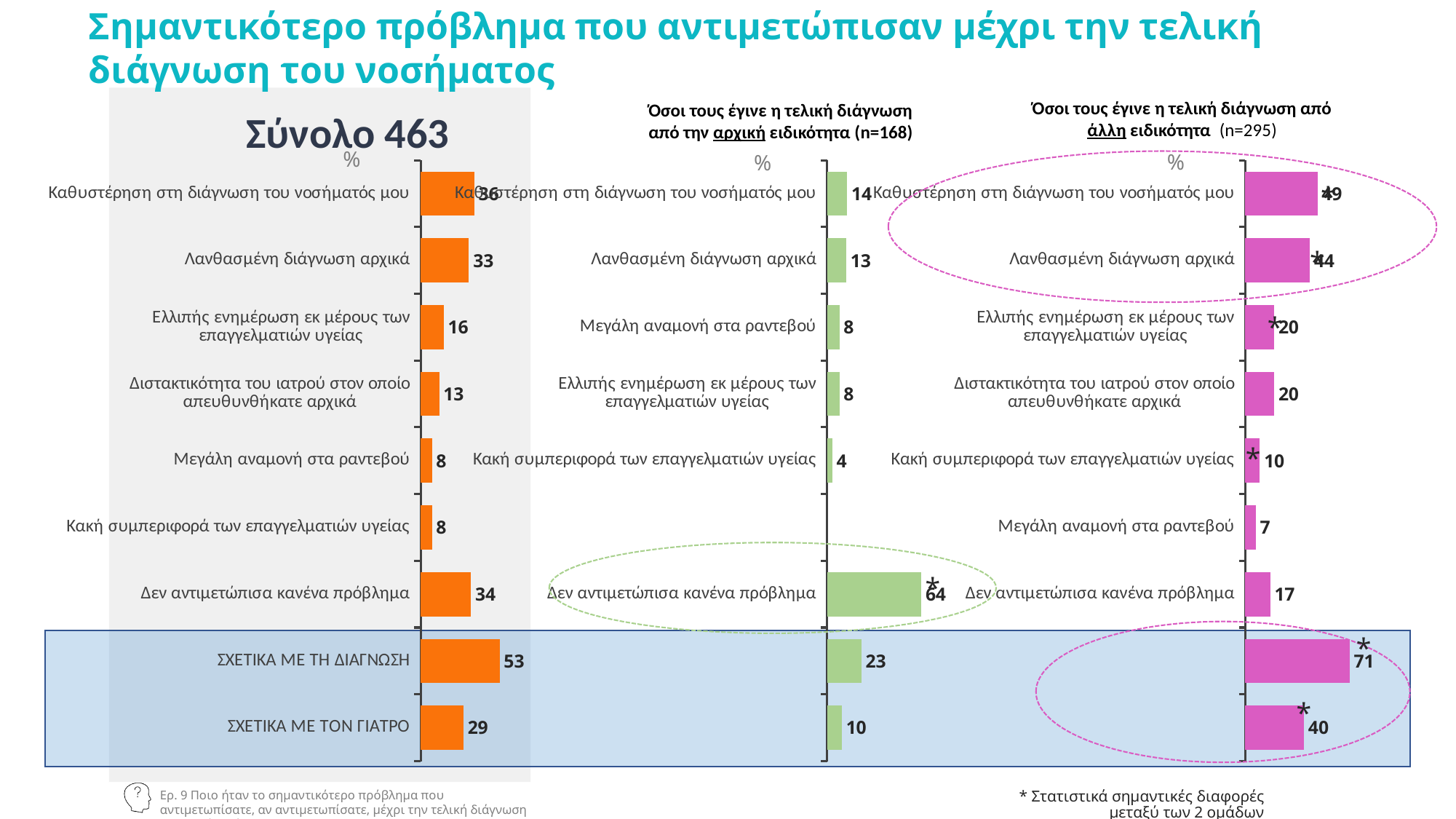
What type of chart is used for the 'Σύνολο 463' data? Bar chart In the 'Σύνολο 463' chart, which is larger: 'Καθυστέρηση στη διάγνωση του νοσήματος μου' or 'Λανθασμένη διάγνωση αρχικά'? Καθυστέρηση στη διάγνωση του νοσήματος μου In the chart for those diagnosed by the 'αρχική ειδικότητα' (n=168), what is the value for 'Δεν αντιμετώπισα κανένα πρόβλημα'? 64 In the 'Σύνολο 463' chart, what is the value for 'Καθυστέρηση στη διάγνωση του νοσήματος μου'? 36 In the 'Σύνολο 463' chart, what is the difference between 'ΣΧΕΤΙΚΑ ΜΕ ΤΗ ΔΙΑΓΝΩΣΗ' and 'ΣΧΕΤΙΚΑ ΜΕ ΤΟΝ ΓΙΑΤΡΟ'? 24 How many categories (bars) are shown in the 'Σύνολο 463' chart? 9 In the chart for those diagnosed by 'άλλη ειδικότητα' (n=295), which category has the highest value? ΣΧΕΤΙΚΑ ΜΕ ΤΗ ΔΙΑΓΝΩΣΗ In the 'Σύνολο 463' chart, what is the value for 'ΣΧΕΤΙΚΑ ΜΕ ΤΗ ΔΙΑΓΝΩΣΗ'? 53 What is the difference between 'ΣΧΕΤΙΚΑ ΜΕ ΤΗ ΔΙΑΓΝΩΣΗ' in the 'άλλη ειδικότητα' chart (71) and in the 'αρχική ειδικότητα' chart (23)? 48 In the chart for those diagnosed by 'άλλη ειδικότητα' (n=295), what is the value for 'Λανθασμένη διάγνωση αρχικά'? 44 In the chart for those diagnosed by the 'αρχική ειδικότητα' (n=168), which category has the lowest value? Κακή συμπεριφορά των επαγγελματιών υγείας Which is larger: 'Δεν αντιμετώπισα κανένα πρόβλημα' in the 'αρχική ειδικότητα' chart or in the 'άλλη ειδικότητα' chart? αρχική ειδικότητα